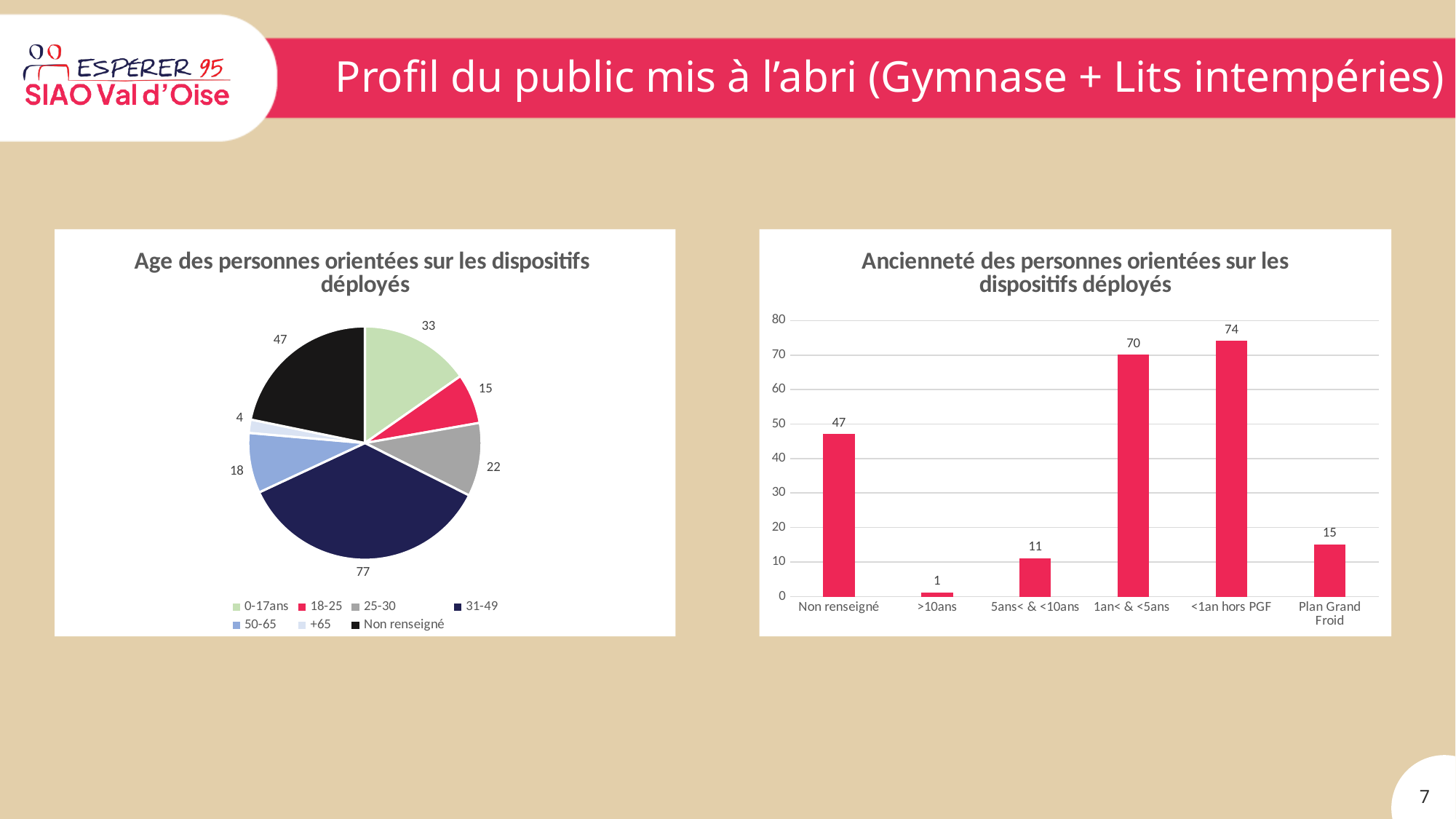
What kind of chart is 'Ancienneté des personnes orientées sur les dispositifs déployés'? Bar chart In the chart 'Age des personnes orientées sur les dispositifs déployés', what is the value for the 31-49 slice? 77 In the chart 'Ancienneté des personnes orientées sur les dispositifs déployés', what is the difference between 'Non renseigné' and 'Plan Grand Froid'? 32 In the chart 'Ancienneté des personnes orientées sur les dispositifs déployés', which category has the highest value? <1an hors PGF In the chart 'Age des personnes orientées sur les dispositifs déployés', which age group has the smallest slice? +65 In the chart 'Age des personnes orientées sur les dispositifs déployés', what is the difference between the 0-17ans value and the 18-25 value? 18 What kind of chart is 'Age des personnes orientées sur les dispositifs déployés'? Pie chart In the chart 'Age des personnes orientées sur les dispositifs déployés', how many slices does the pie have? 7 In the chart 'Ancienneté des personnes orientées sur les dispositifs déployés', how many categories are shown on the x axis? 6 In the chart 'Ancienneté des personnes orientées sur les dispositifs déployés', what is the value for '<1an hors PGF'? 74 In the chart 'Ancienneté des personnes orientées sur les dispositifs déployés', which category has the lowest value? >10ans In the chart 'Age des personnes orientées sur les dispositifs déployés', which age group has the largest slice? 31-49